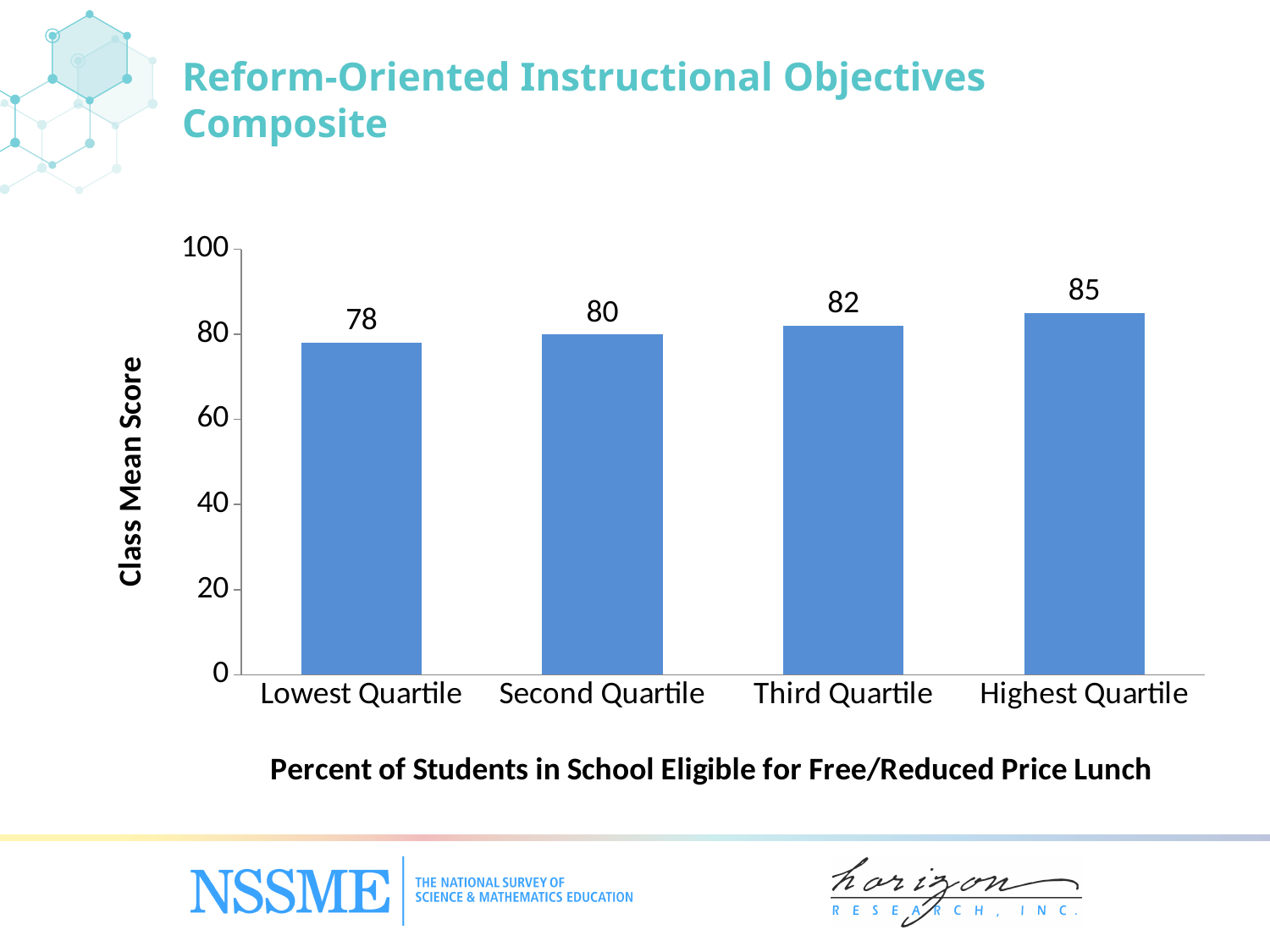
What is the class mean score for the Second Quartile? 80 What is the label of the y axis? Class Mean Score What is the class mean score for the Third Quartile? 82 What is the difference between the class mean scores of the Highest Quartile and the Lowest Quartile? 7 How many quartile categories are shown on the x axis? 4 Do the class mean scores rise or fall from the Lowest Quartile to the Highest Quartile? Rise What is the class mean score for the Lowest Quartile? 78 What kind of chart is shown on the slide? Bar chart Which quartile has the lowest class mean score? Lowest Quartile Which has a higher class mean score, the Second Quartile or the Third Quartile? Third Quartile What is the class mean score for the Highest Quartile? 85 Which quartile has the highest class mean score? Highest Quartile